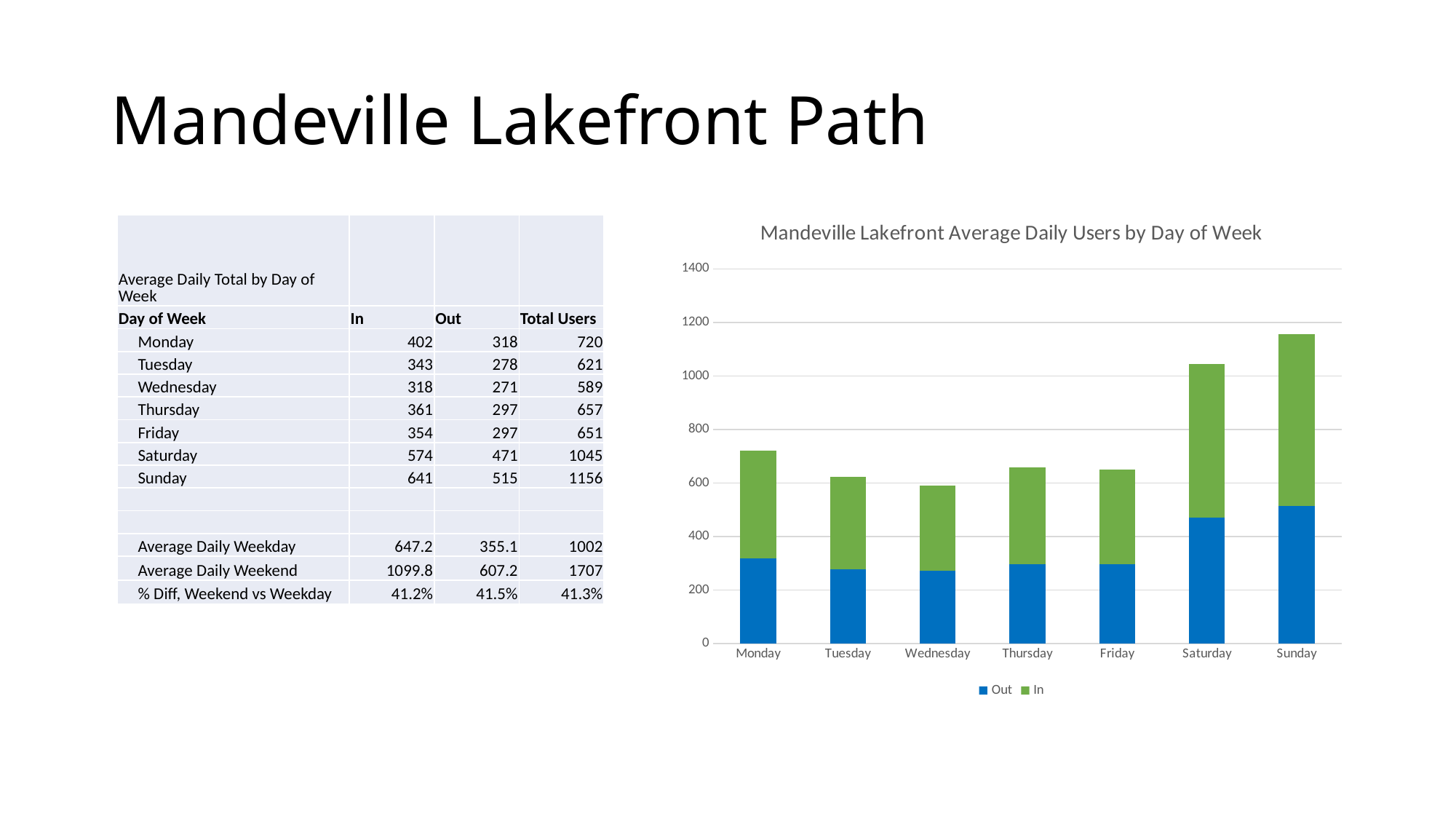
According to the slide, what is the In value for Saturday? 574 Which day has the shortest stacked bar in the chart? Wednesday Which day has the tallest stacked bar in the chart? Sunday According to the slide, what is the total average daily users for Sunday? 1156 What is the title of the chart? Mandeville Lakefront Average Daily Users by Day of Week How many series does the chart legend list? 2 Is the Out segment for Sunday greater or less than 400? greater Which is larger in the chart, the stacked bar for Monday or the stacked bar for Tuesday? Monday Is the total stacked bar for Saturday greater or less than 1000? greater How many days of the week are plotted on the x axis of the chart? 7 What kind of chart is shown on the slide? stacked bar chart